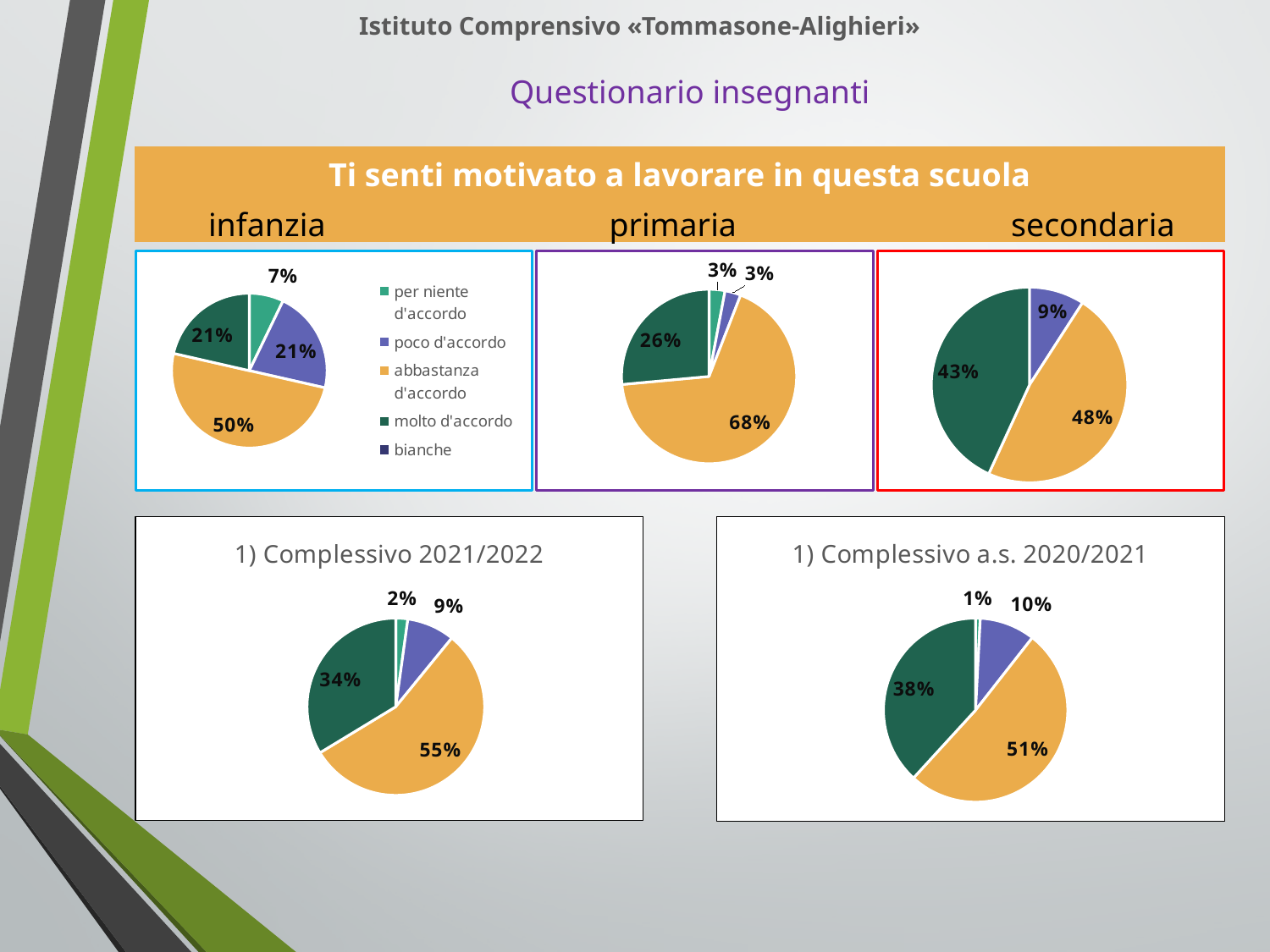
In the secondaria pie chart, what is the difference between the 'abbastanza d'accordo' and 'molto d'accordo' shares? 5% In the 'Complessivo 2021/2022' pie chart, which category has the smallest share? per niente d'accordo In the secondaria pie chart, what percentage is shown for 'poco d'accordo'? 9% In the 'Complessivo a.s. 2020/2021' pie chart, what percentage is shown for 'abbastanza d'accordo'? 51% In the primaria pie chart, which category has the largest share? abbastanza d'accordo In the infanzia pie chart, which is larger: 'per niente d'accordo' or 'poco d'accordo'? poco d'accordo What type of chart is used for the infanzia data? pie chart In the primaria pie chart, what percentage is shown for 'molto d'accordo'? 26% How many entries does the legend next to the infanzia chart list? 5 In the 'Complessivo 2021/2022' pie chart, what percentage is shown for 'molto d'accordo'? 34% In the infanzia pie chart, what percentage is shown for 'abbastanza d'accordo'? 50% How many slices with data labels does the secondaria pie chart have? 3